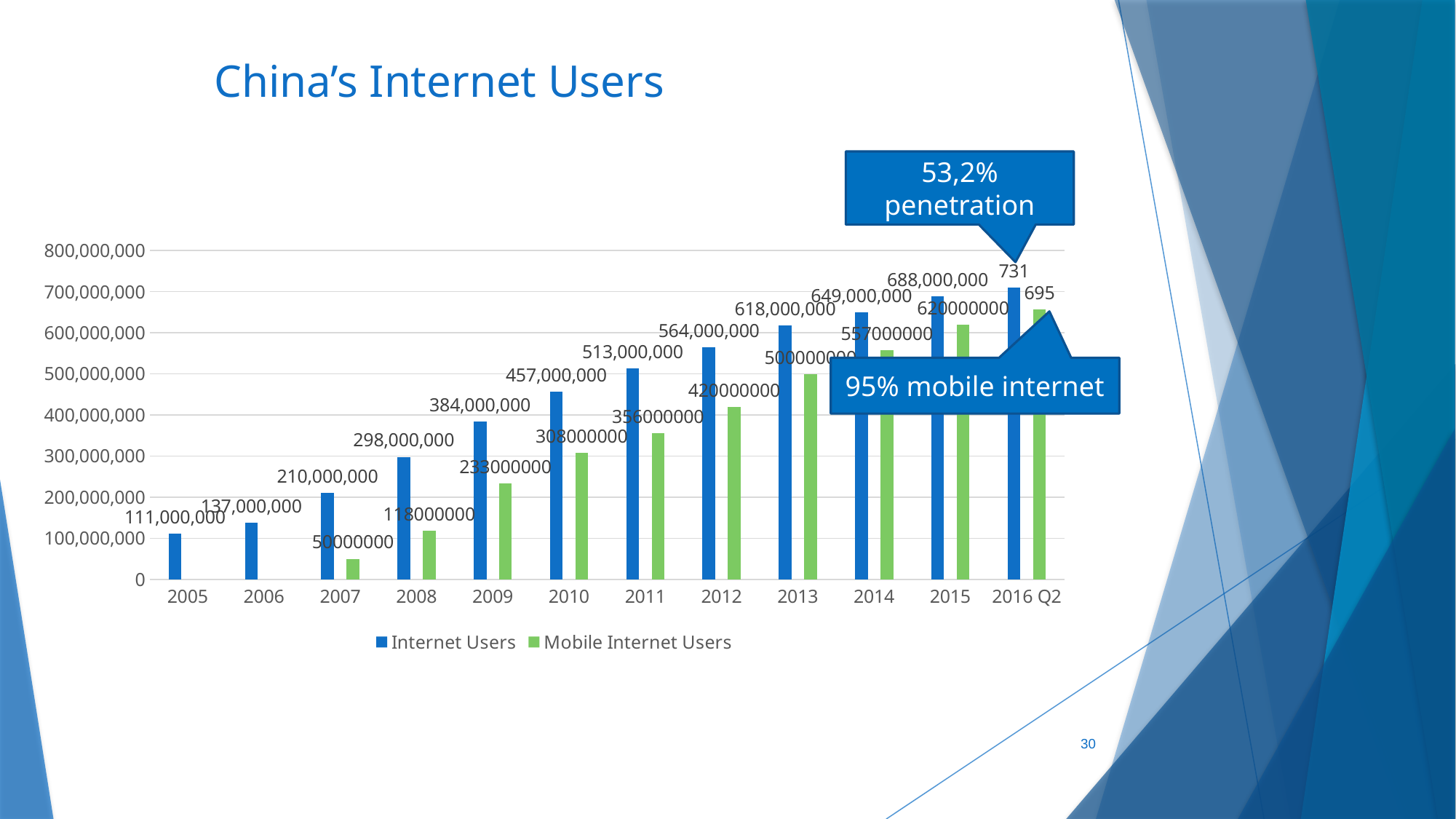
What kind of chart is shown on the slide? bar chart How many series does the legend list? 2 What is the value for Mobile Internet Users in 2012? 420000000 In 2011, which is larger: Internet Users or Mobile Internet Users? Internet Users Is the value for Mobile Internet Users in 2016 Q2 greater or less than 600,000,000? greater Do the Internet Users values rise or fall from 2005 to 2016 Q2? rise What is the value for Internet Users in 2005? 111,000,000 Which year has the lowest value for Internet Users? 2005 How many years (categories) are shown on the x axis? 12 What is the value for Mobile Internet Users in 2008? 118000000 What is the value for Internet Users in 2010? 457,000,000 What is the difference between Internet Users in 2014 and in 2013? 31,000,000